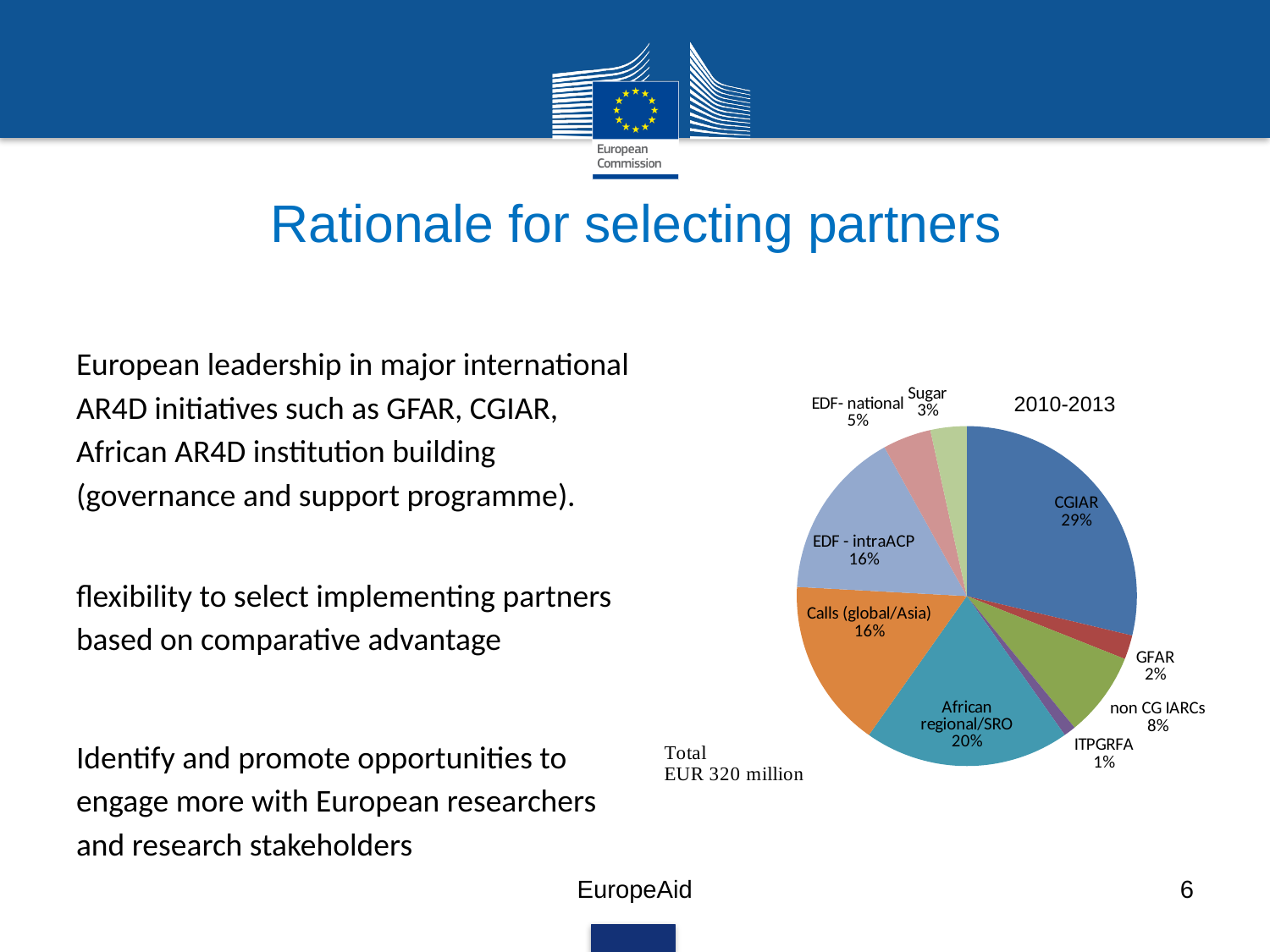
What percentage is shown for Sugar? 3% Which category has the smallest slice of the pie? ITPGRFA What percentage is shown for EDF - intraACP? 16% How many slices does the pie chart have? 9 Which category has the largest slice of the pie? CGIAR What is the difference in percentage points between CGIAR and African regional/SRO? 9 What is the title of the pie chart? 2010-2013 What percentage is shown for non CG IARCs? 8% What kind of chart is shown on the slide? pie chart What share of the pie does African regional/SRO account for? 20% Which is larger, the share for EDF- national or the share for GFAR? EDF- national What share of the pie does CGIAR account for? 29%